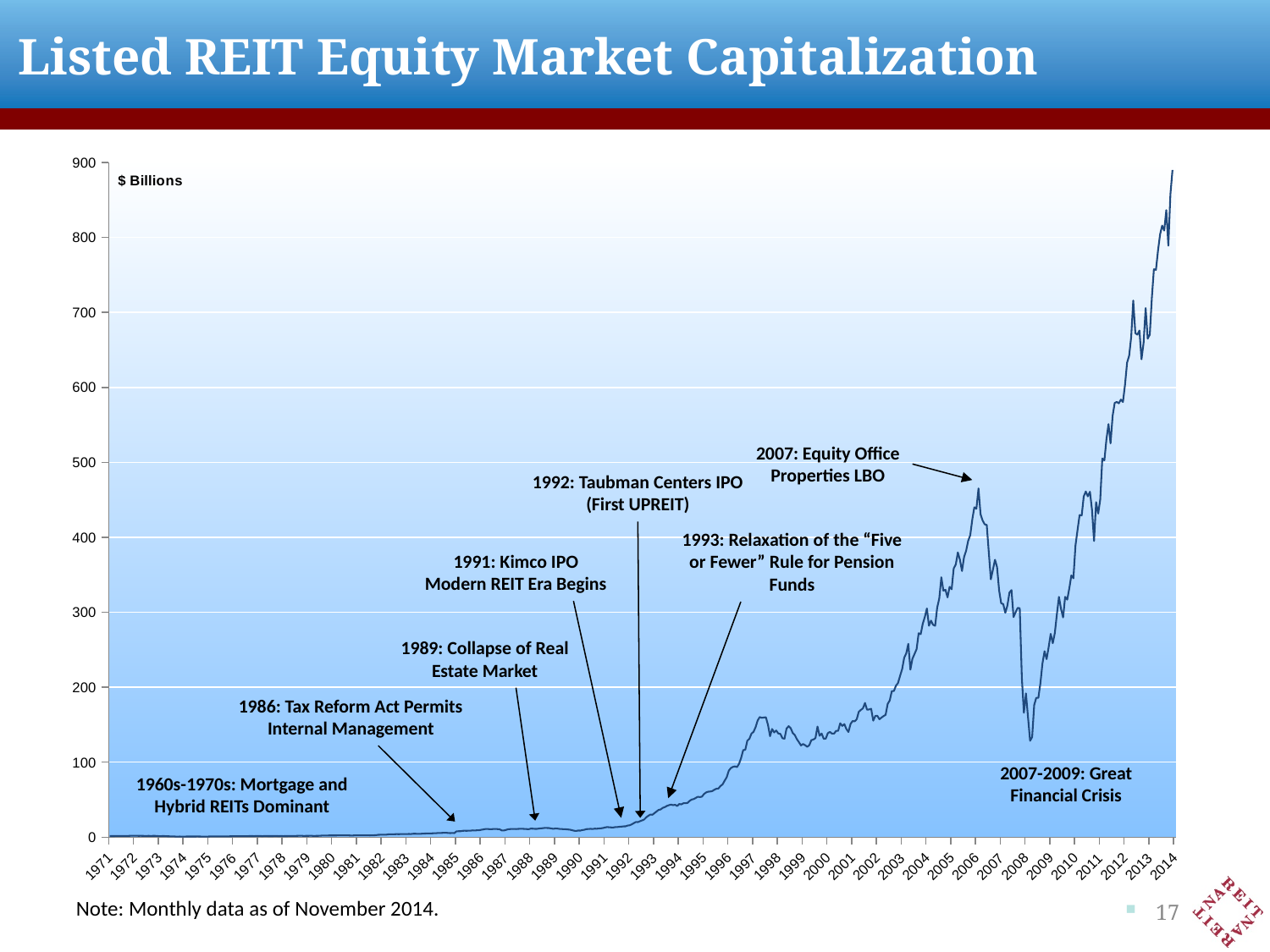
According to the annotation, what event is marked for 1991? Kimco IPO, Modern REIT Era Begins Is the trough value in early 2009 greater or less than 200? less Overall, does the market capitalization rise or fall from 1971 to 2014? rise What kind of chart is shown on the slide? Line chart Is the peak value around 2006-2007 greater or less than 400? greater How many year labels are shown on the x axis? 44 Is the value in 2000 greater or less than 100? greater Which is larger, the market capitalization in 2014 or in 1997? 2014 In which year does the line reach its highest value? 2014 What is the title of the chart? Listed REIT Equity Market Capitalization